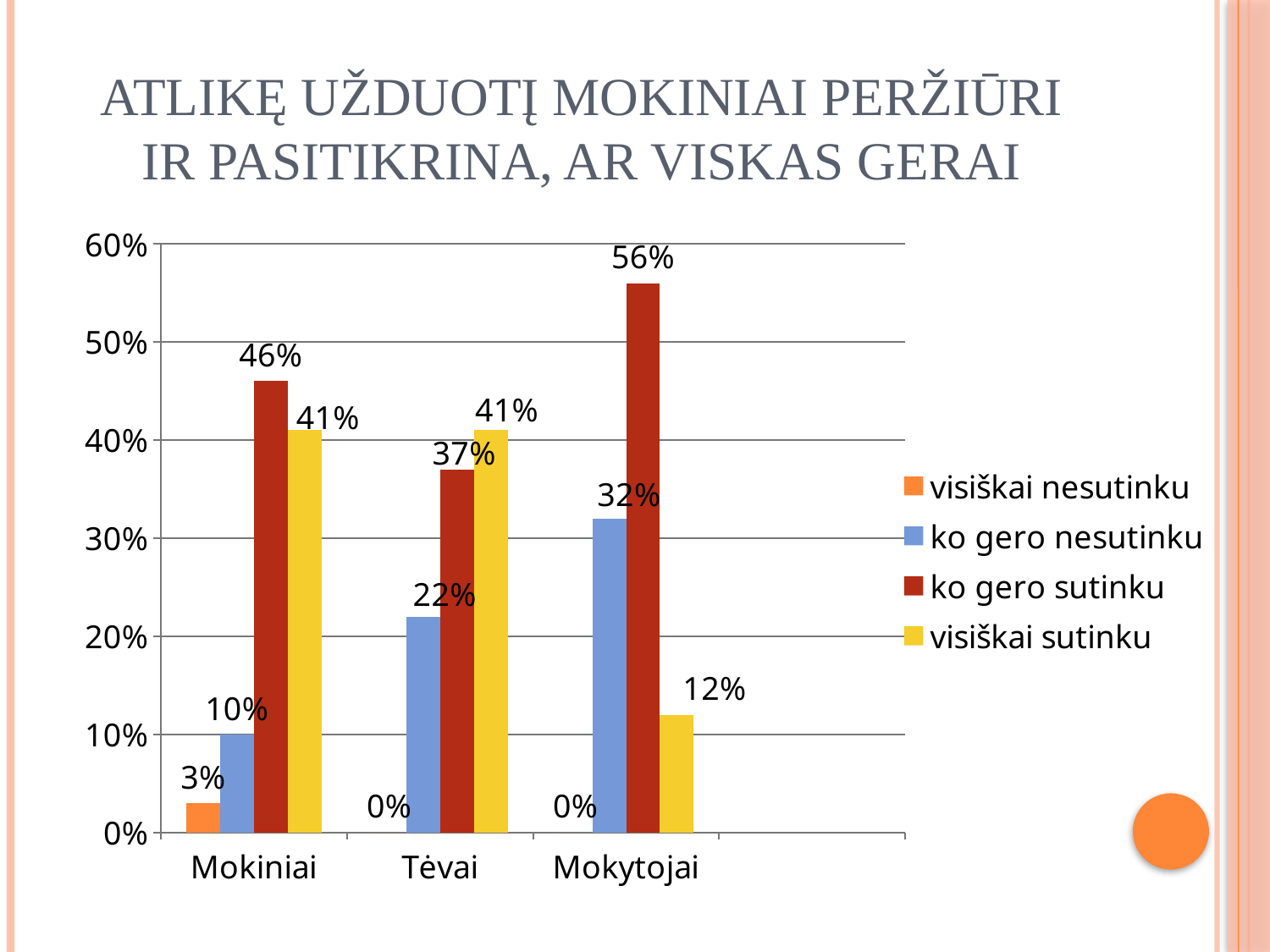
Which category has the lowest value for "visiškai sutinku"? Mokytojai What is the value for "ko gero nesutinku" in the Tėvai category? 22% What is the value for "visiškai nesutinku" in the Mokiniai category? 3% What is the difference between the "ko gero sutinku" values for Mokytojai and Mokiniai? 10% Which colour represents the "visiškai sutinku" series? Yellow What is the value for "ko gero sutinku" in the Mokytojai category? 56% How many categories are shown on the x axis? 3 Which is larger: "ko gero nesutinku" for Mokytojai or "ko gero nesutinku" for Tėvai? Mokytojai What is the value for "visiškai sutinku" in the Mokytojai category? 12% Which category has the highest value for "ko gero sutinku"? Mokytojai What kind of chart is shown on the slide? Bar chart How many series does the legend list? 4